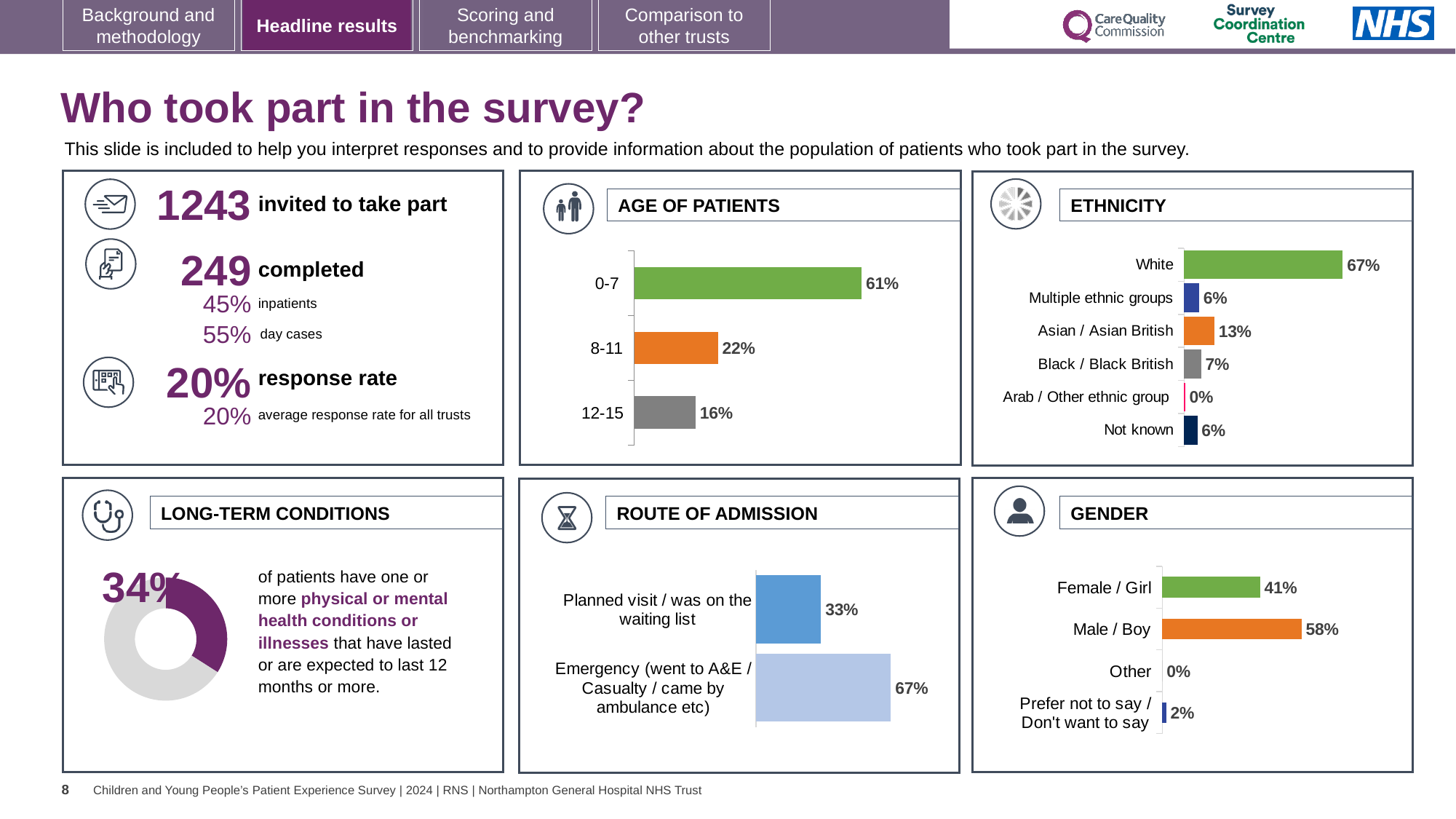
In the GENDER chart, what is the difference between the Male / Boy and Female / Girl percentages? 17% In the ETHNICITY chart, what percentage of patients are Asian / Asian British? 13% In the ROUTE OF ADMISSION chart, what percentage of patients came via Emergency (went to A&E / Casualty / came by ambulance etc)? 67% In the ETHNICITY chart, how many ethnicity categories are shown? 6 In the ROUTE OF ADMISSION chart, what is the difference between the Emergency and Planned visit percentages? 34% In the AGE OF PATIENTS chart, what is the difference between the 8-11 and 12-15 percentages? 6% In the ETHNICITY chart, which is larger: Black / Black British or Multiple ethnic groups? Black / Black British In the GENDER chart, what percentage of patients are Male / Boy? 58% In the AGE OF PATIENTS chart, which age group has the lowest percentage? 12-15 In the ETHNICITY chart, which category has the highest percentage? White In the AGE OF PATIENTS chart, what percentage of patients are aged 0-7? 61% What kind of chart is used in the LONG-TERM CONDITIONS panel? Donut (pie) chart